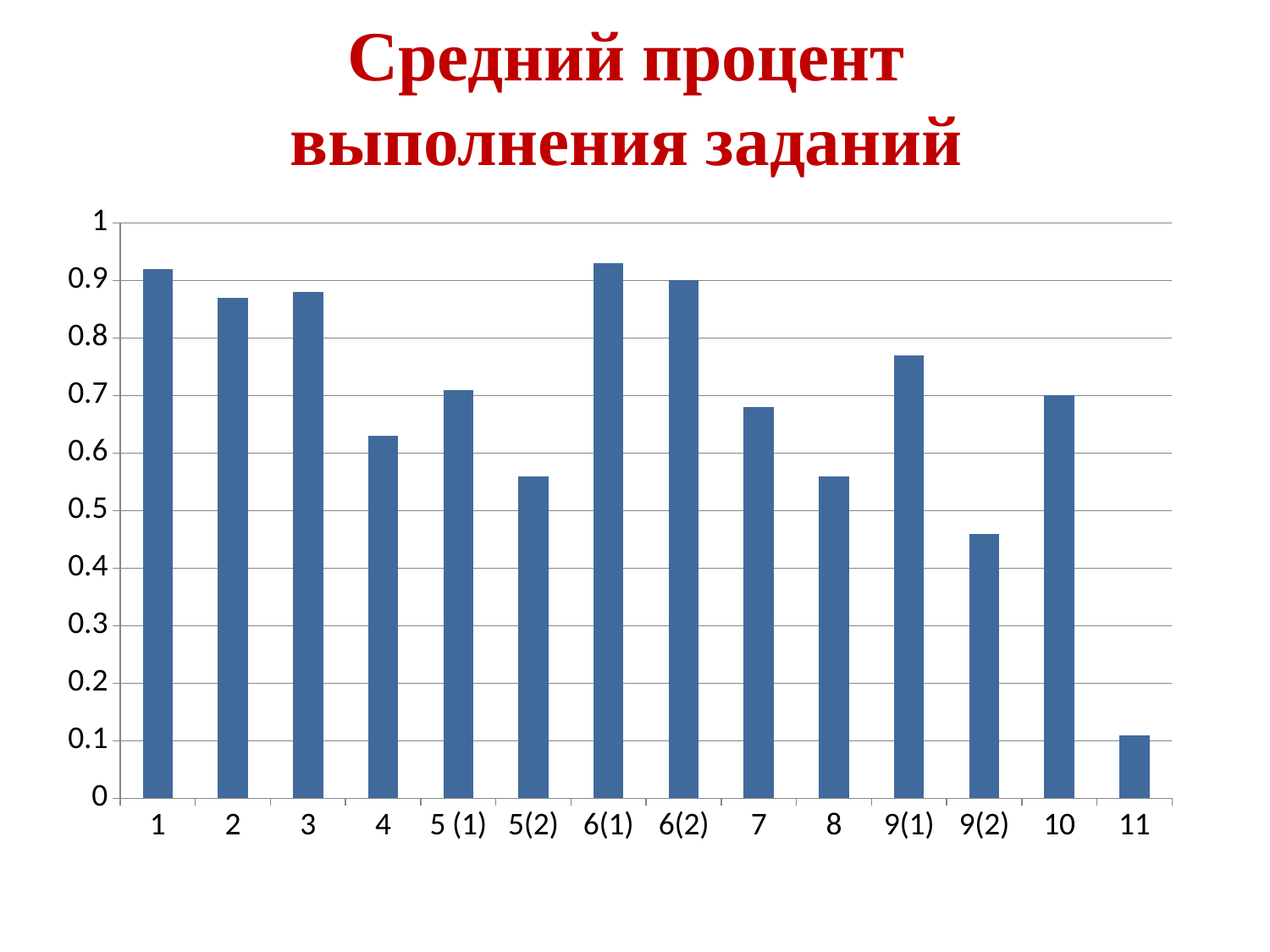
Is the value for category 9(1) greater or less than 0.8? less Is the value for category 9(2) greater or less than 0.5? less Which category has the lowest value? 11 Which is larger, the value for category 1 or the value for category 4? 1 What is the value for category 10? 0.7 What is the value for category 6(2)? 0.9 How many categories are shown on the x axis? 14 What kind of chart is shown on the slide? bar chart Is the value for category 11 greater or less than 0.2? less Which is larger, the value for category 9(1) or the value for category 9(2)? 9(1) What is the title of the chart? Средний процент выполнения заданий